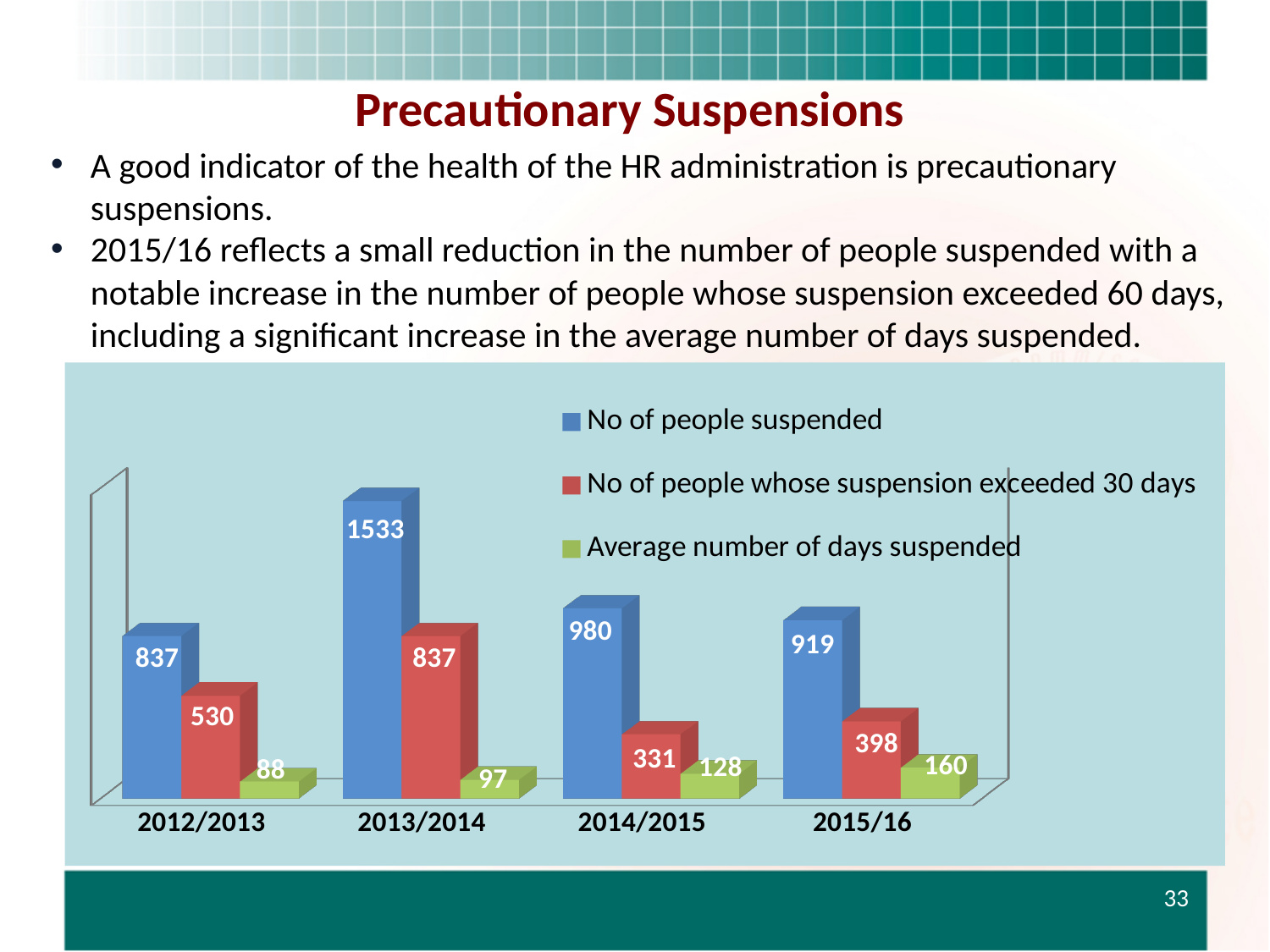
How many years are shown on the x axis of the chart? 4 What kind of chart is shown on the slide? Bar chart Which colour represents the 'Average number of days suspended' series in the chart? Green Which is larger: the number of people whose suspension exceeded 30 days in 2012/2013 or in 2015/16? 2012/2013 How many people had a suspension exceeding 30 days in 2014/2015? 331 What is the number of people suspended in 2013/2014? 1533 What is the difference between the number of people suspended in 2013/2014 and in 2014/2015? 553 Which year has the highest number of people suspended? 2013/2014 Which year has the lowest average number of days suspended? 2012/2013 Does the average number of days suspended rise or fall from 2013/2014 to 2015/16? Rise What is the average number of days suspended in 2015/16? 160 How many series does the chart's legend list? 3